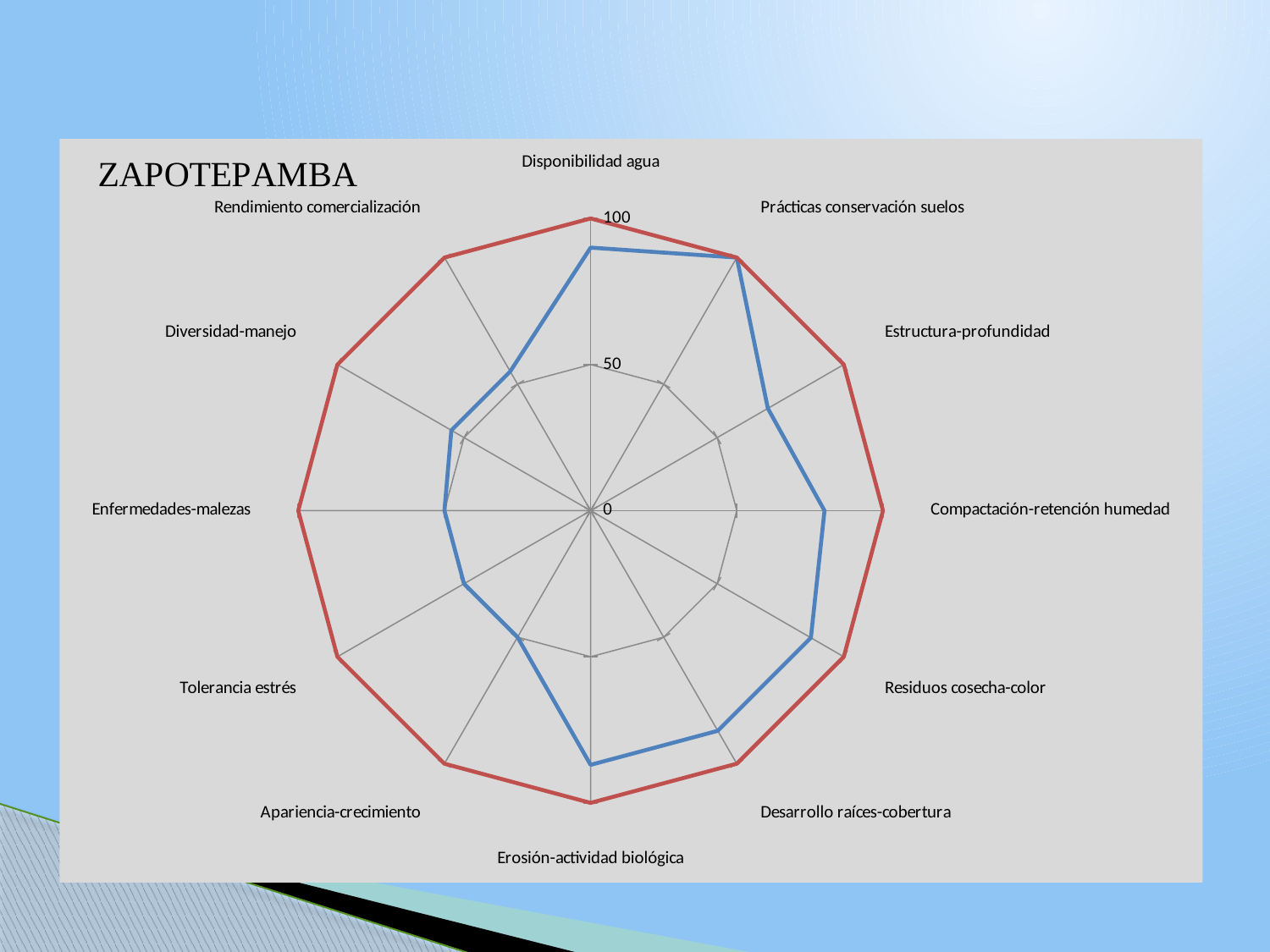
How many categories (axes) does the radar chart have? 12 How many data series are plotted on the radar chart? 2 What kind of chart is shown on the slide? Radar chart For the blue series, which is larger: the value for Compactación-retención humedad or the value for Enfermedades-malezas? Compactación-retención humedad Is the blue series value for Disponibilidad agua greater or less than 50? greater For Enfermedades-malezas, which series has the larger value, the red or the blue? Red Is the blue series value for Erosión-actividad biológica greater or less than 50? greater What is the title shown on the chart? ZAPOTEPAMBA For which category does the blue series reach its highest value? Prácticas conservación suelos What value does the red series reach for Disponibilidad agua? 100 What is the maximum value shown on the radar chart's axis scale? 100 Is the blue series value for Compactación-retención humedad greater or less than 50? greater